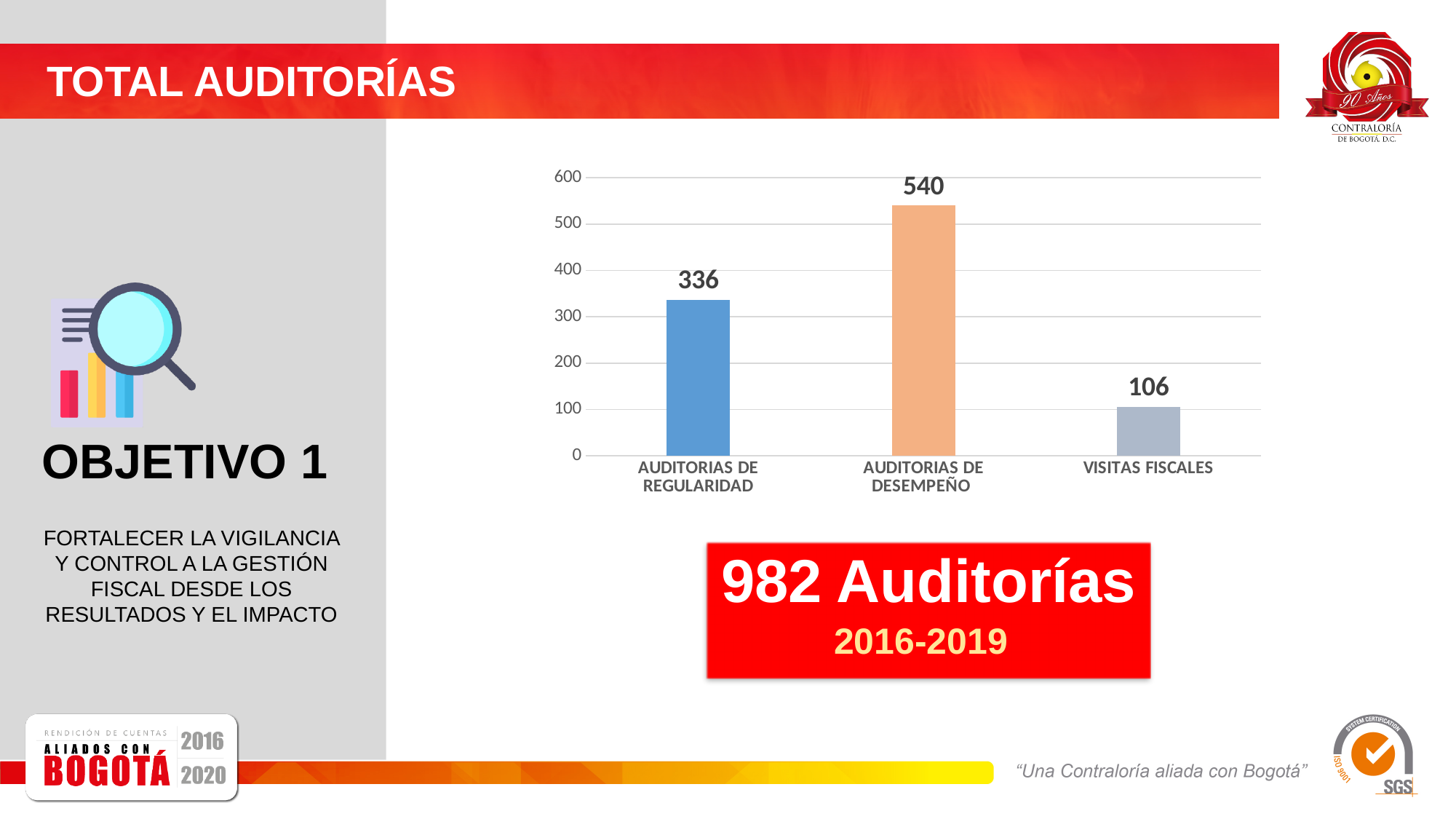
Which is larger, AUDITORIAS DE REGULARIDAD or VISITAS FISCALES? AUDITORIAS DE REGULARIDAD Which category has the highest value? AUDITORIAS DE DESEMPEÑO What kind of chart is shown on the slide? bar chart How many categories are shown in the chart? 3 What is the value for AUDITORIAS DE DESEMPEÑO? 540 Is the value for AUDITORIAS DE DESEMPEÑO greater or less than 500? greater What is the value for VISITAS FISCALES? 106 What is the total number of auditorías for 2016-2019 stated on the slide? 982 What is the value for AUDITORIAS DE REGULARIDAD? 336 What is the difference between AUDITORIAS DE REGULARIDAD and VISITAS FISCALES? 230 Which category has the lowest value? VISITAS FISCALES What is the difference between AUDITORIAS DE DESEMPEÑO and AUDITORIAS DE REGULARIDAD? 204